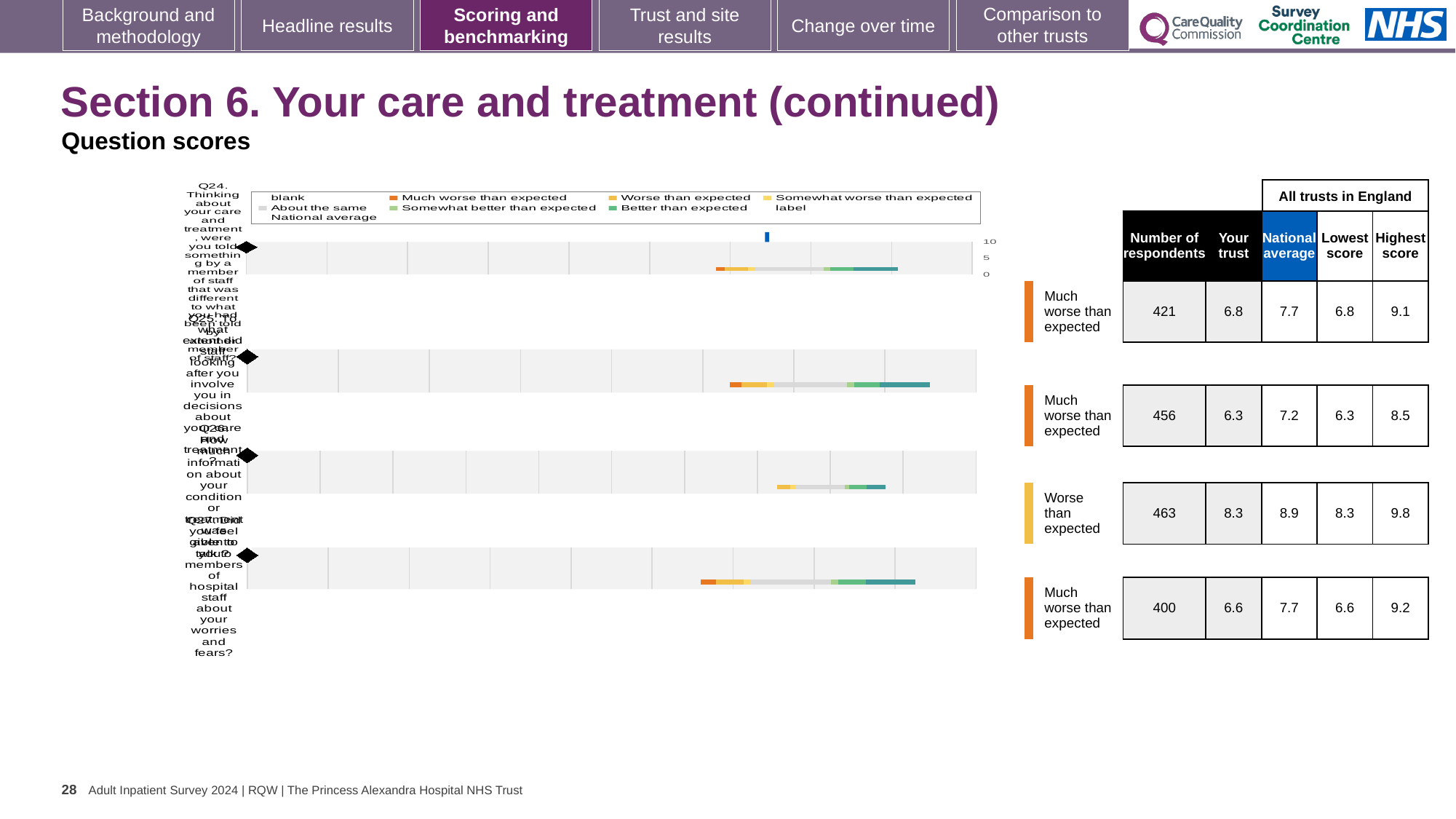
What is the maximum value shown on the x axis of the top chart? 10 For the third chart (Q26), what is the lowest score across all trusts in England? 8.3 Which of the four charts has the highest 'Your trust' score? The third chart (Q26), 8.3 How many question score charts are shown on the slide? 4 For the second chart (Q25), how many respondents are shown in the table? 456 What kind of chart is used to show the question scores on this slide? bar chart For the bottom chart (Q27), what is the highest score across all trusts in England? 9.2 For the third chart (Q26), what is the national average shown in the table? 8.9 For the second chart (Q25), what is the difference between the national average and the 'Your trust' score? 0.9 What benchmark category label is shown beside the third chart (Q26)? Worse than expected For the top chart (Q24), which is larger: the 'Your trust' score or the national average? National average For the top chart (Q24), what is the 'Your trust' score shown in the table? 6.8